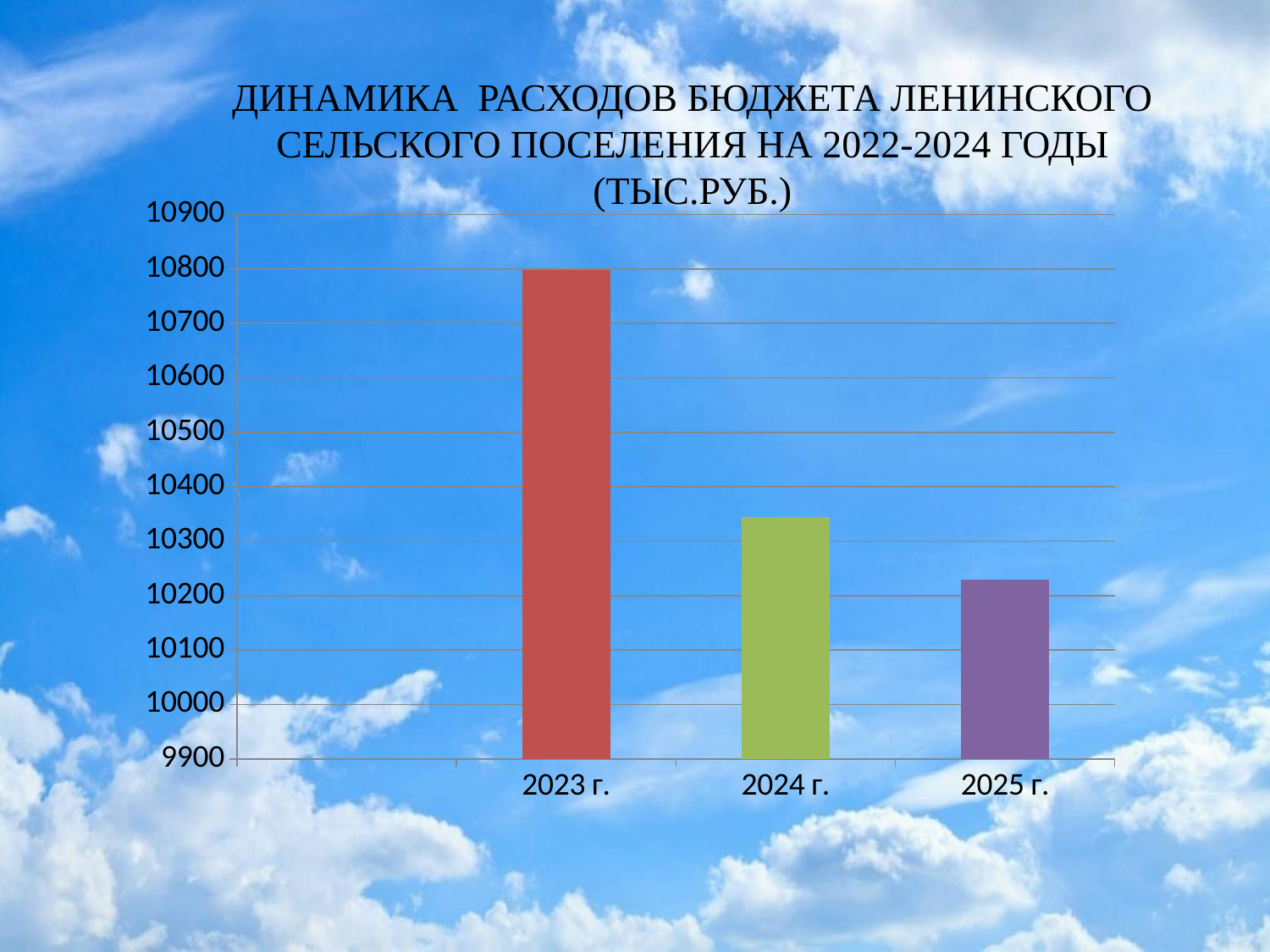
Which year has the lowest value in the chart? 2025 г. What is the lowest value shown on the vertical axis? 9900 What kind of chart is shown on the slide? bar chart What colour is the bar for 2023 г.? red Is the value for 2025 г. greater or less than 10200? greater Is the value for 2023 г. greater or less than 10500? greater How many bars (categories) are plotted in the chart? 3 Which year has the highest value in the chart? 2023 г. Do the values rise or fall from 2023 г. to 2025 г.? fall Which is larger, the value for 2024 г. or the value for 2025 г.? 2024 г. Is the value for 2024 г. greater or less than 10300? greater